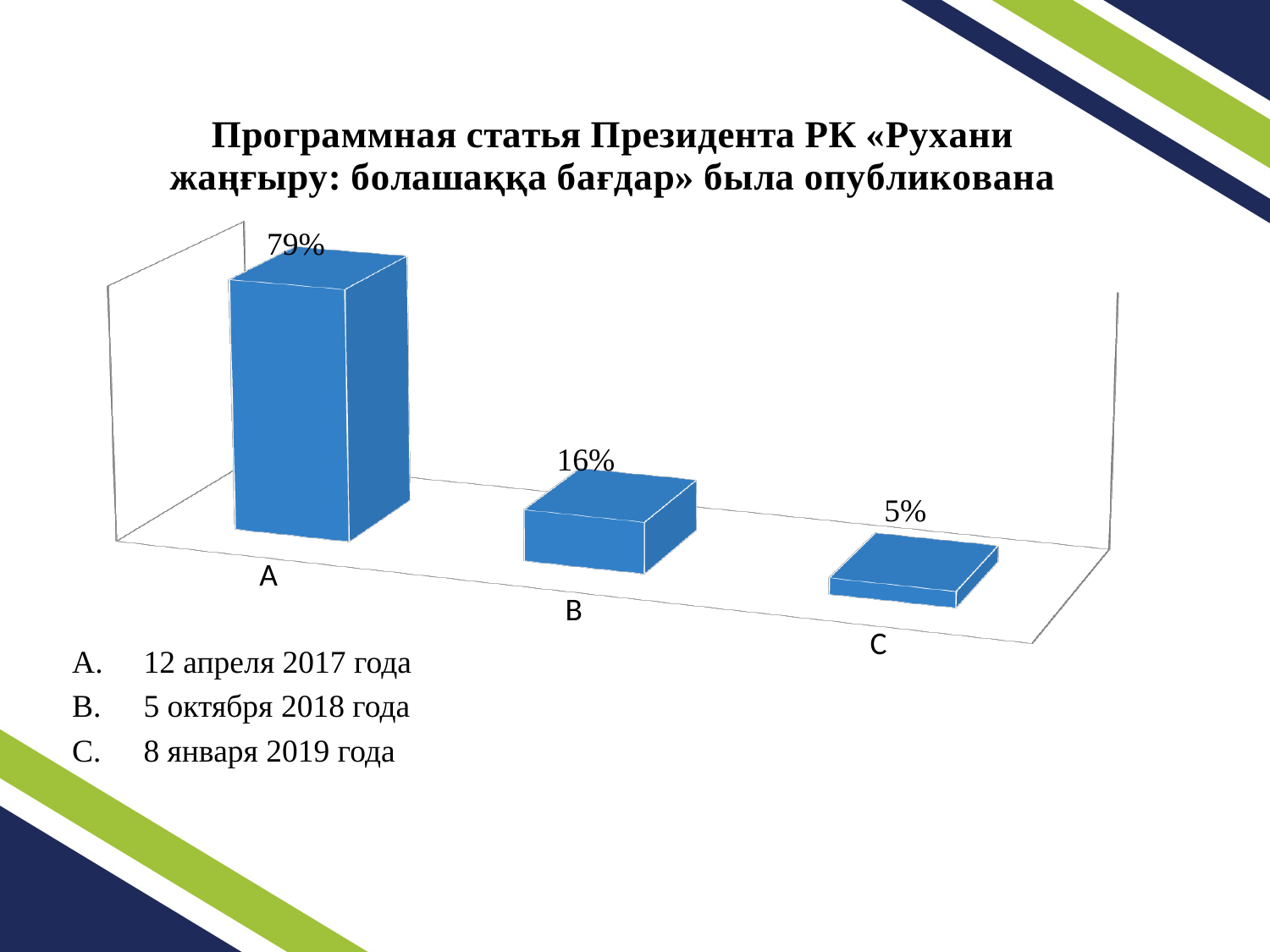
What kind of chart is shown on the slide? bar chart What is the value for category A? 79% What is the value for category B? 16% Which category has the highest value? A What is the difference between the values for B and C? 11% Which is larger, the value for B or the value for C? B Which category has the lowest value? C What is the difference between the values for A and B? 63% Do the values rise or fall from A to C along the x axis? fall How many categories are shown in the chart? 3 What is the value for category C? 5% What colour are the bars in the chart? blue